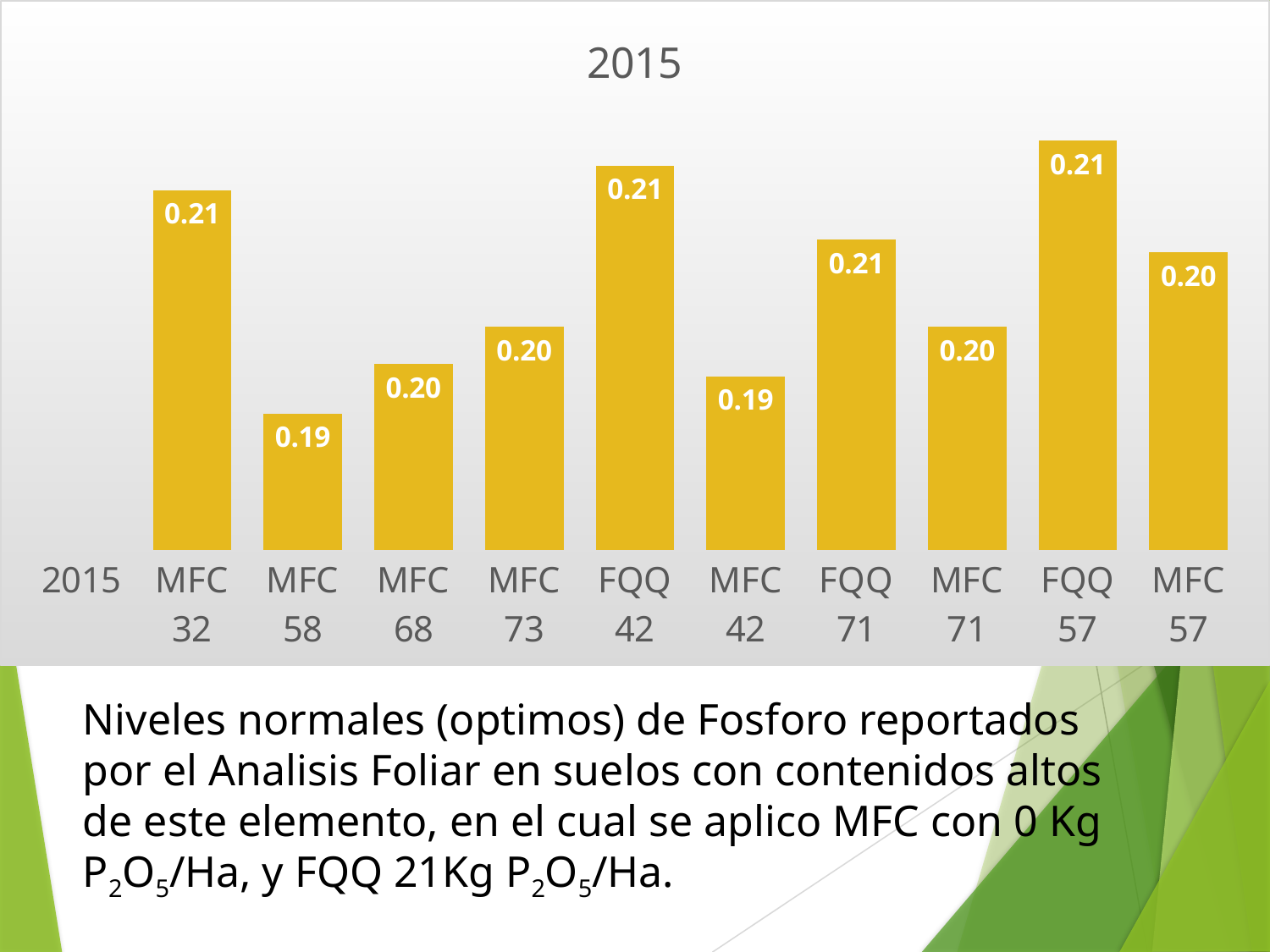
What is the value for MFC 58? 0.19 What is the difference between the values for MFC 32 and MFC 58? 0.02 Which is larger, the value for FQQ 42 or the value for MFC 73? FQQ 42 What is the value for MFC 71? 0.20 Which category has the tallest bar? FQQ 57 What kind of chart is shown on the slide? Bar chart What is the value for FQQ 42? 0.21 What is the value for MFC 32? 0.21 What is the value for MFC 42? 0.19 Which is larger, the value for MFC 68 or the value for MFC 42? MFC 68 How many bars are plotted in the chart? 10 What is the value for MFC 57? 0.20